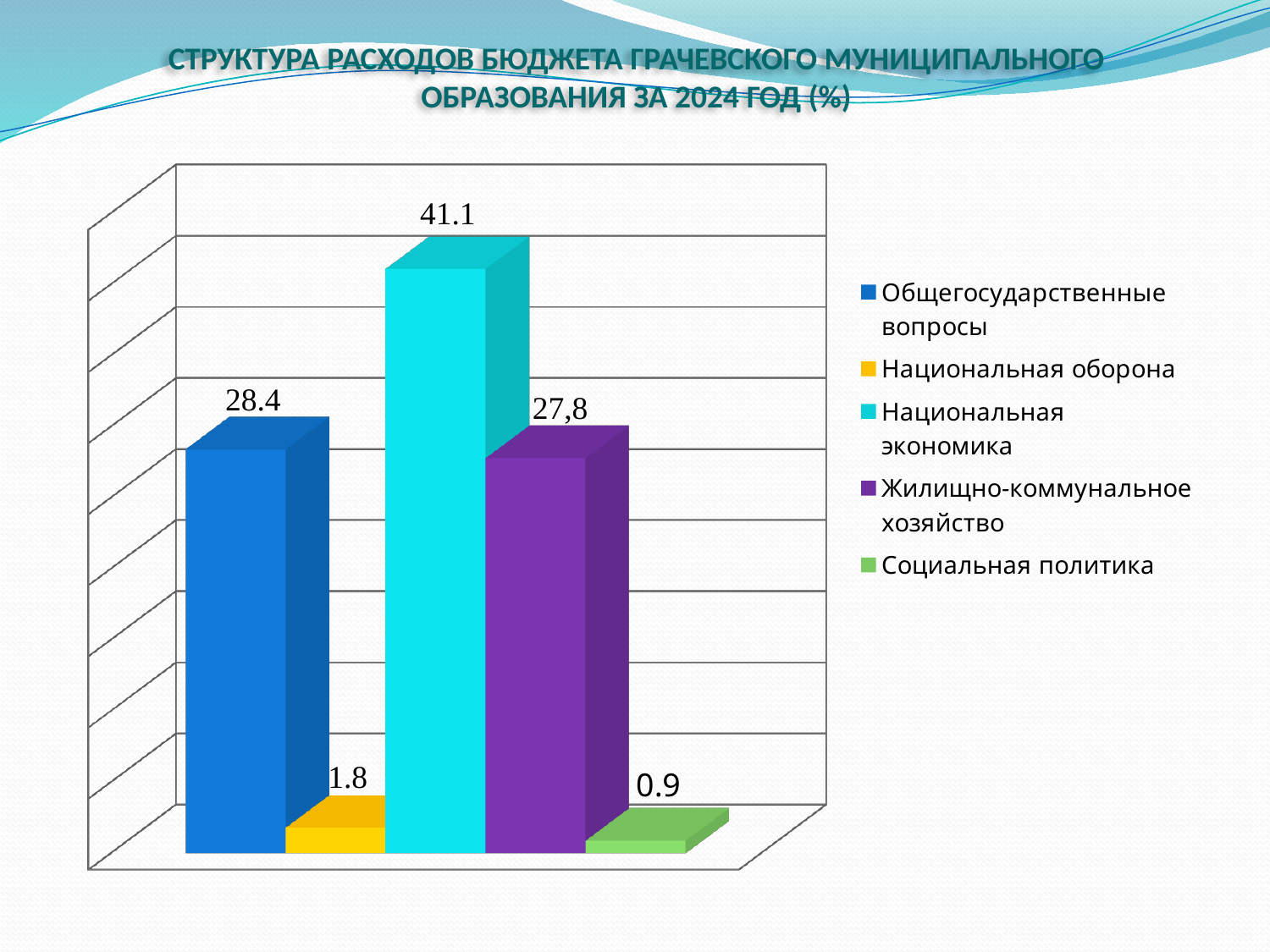
What is the difference between the values for Национальная оборона and Социальная политика? 0.9 What is the value for Жилищно-коммунальное хозяйство? 27,8 What is the value for Национальная оборона? 1.8 What is the value for Социальная политика? 0.9 How many entries does the legend list? 5 What is the value for Национальная экономика? 41.1 Which is larger, the value for Общегосударственные вопросы or the value for Жилищно-коммунальное хозяйство? Общегосударственные вопросы What is the difference between the values for Национальная экономика and Общегосударственные вопросы? 12.7 Which category has the highest value? Национальная экономика What kind of chart is shown on the slide? Bar chart What is the value for Общегосударственные вопросы? 28.4 Which category has the lowest value? Социальная политика